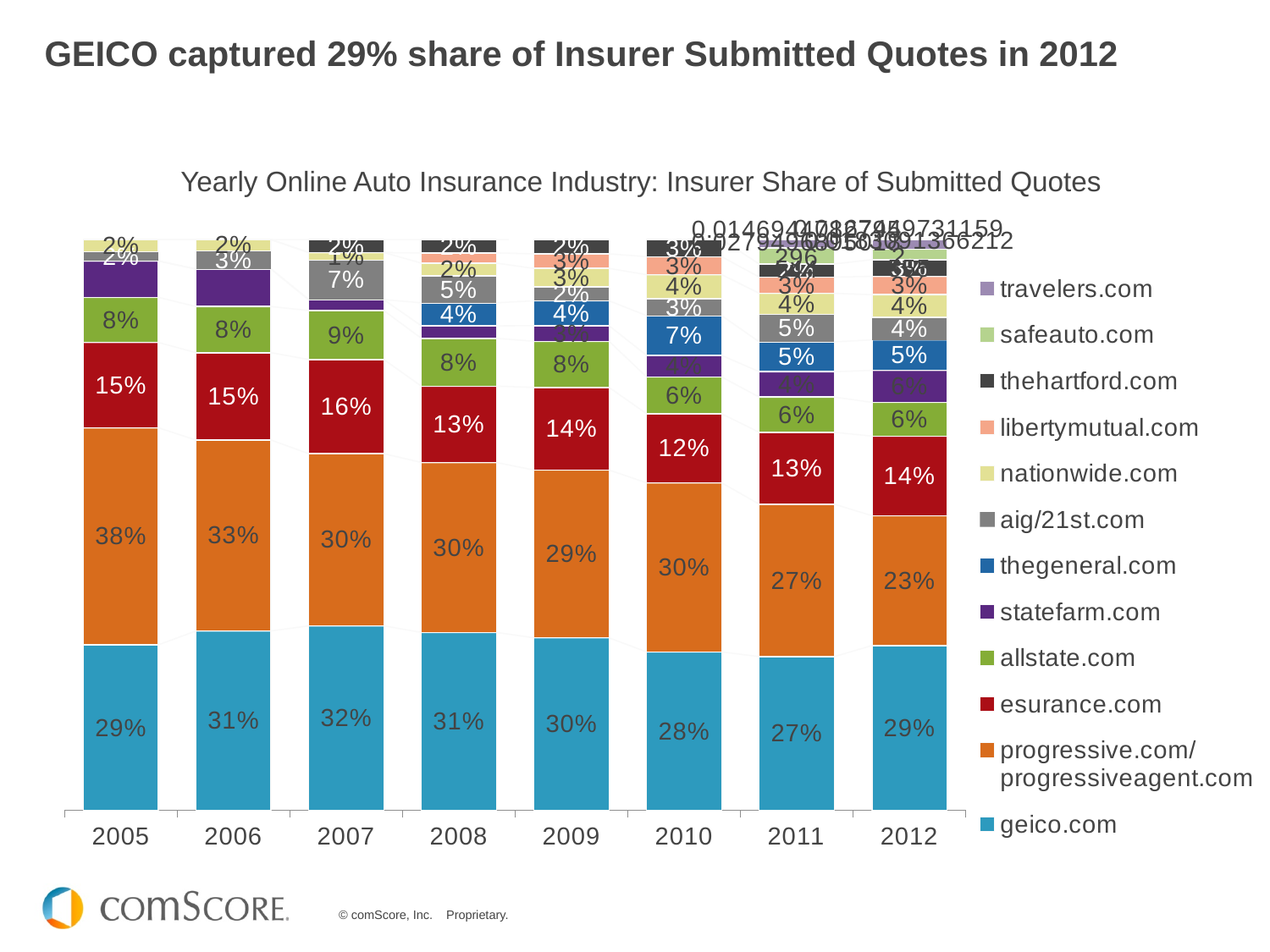
Does the progressive.com/progressiveagent.com share generally rise or fall from 2005 to 2012? Fall What is the share for esurance.com in 2007? 16% How many series does the legend list? 12 In which year is the geico.com share highest? 2007 In which year is the progressive.com/progressiveagent.com share lowest? 2012 In 2012, which has the larger share: geico.com or progressive.com/progressiveagent.com? geico.com What is the share for thegeneral.com in 2010? 7% What is the share for geico.com in 2012? 29% What is the share for progressive.com/progressiveagent.com in 2005? 38% How many years are shown along the x axis? 8 By how many percentage points did the progressive.com/progressiveagent.com share fall from 2005 to 2012? 15 percentage points What kind of chart is shown on the slide? Stacked bar chart